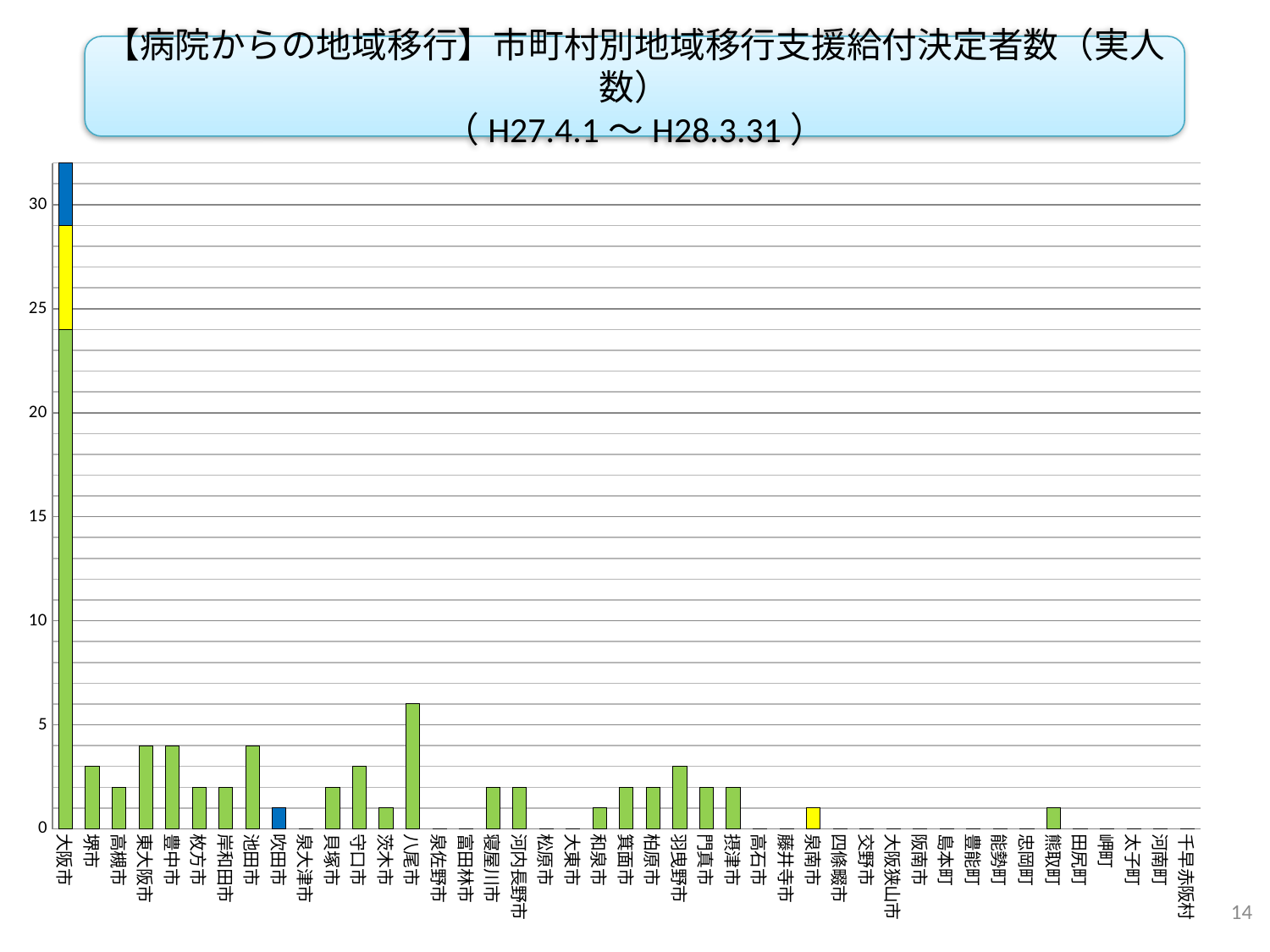
What colour is the topmost segment of the 大阪市 bar? blue Is the total value for 大阪市 greater or less than 30? greater Is the value for 八尾市 greater or less than 5? greater How many municipalities are listed along the x axis of the chart? 43 Is the value for 東大阪市 greater or less than 5? less What is the period shown in the chart title? H27.4.1 ～ H28.3.31 Which has the larger value, 八尾市 or 堺市? 八尾市 What kind of chart is shown on the slide? bar chart Which municipality has the highest value in the chart? 大阪市 Which has the larger value, 大阪市 or 八尾市? 大阪市